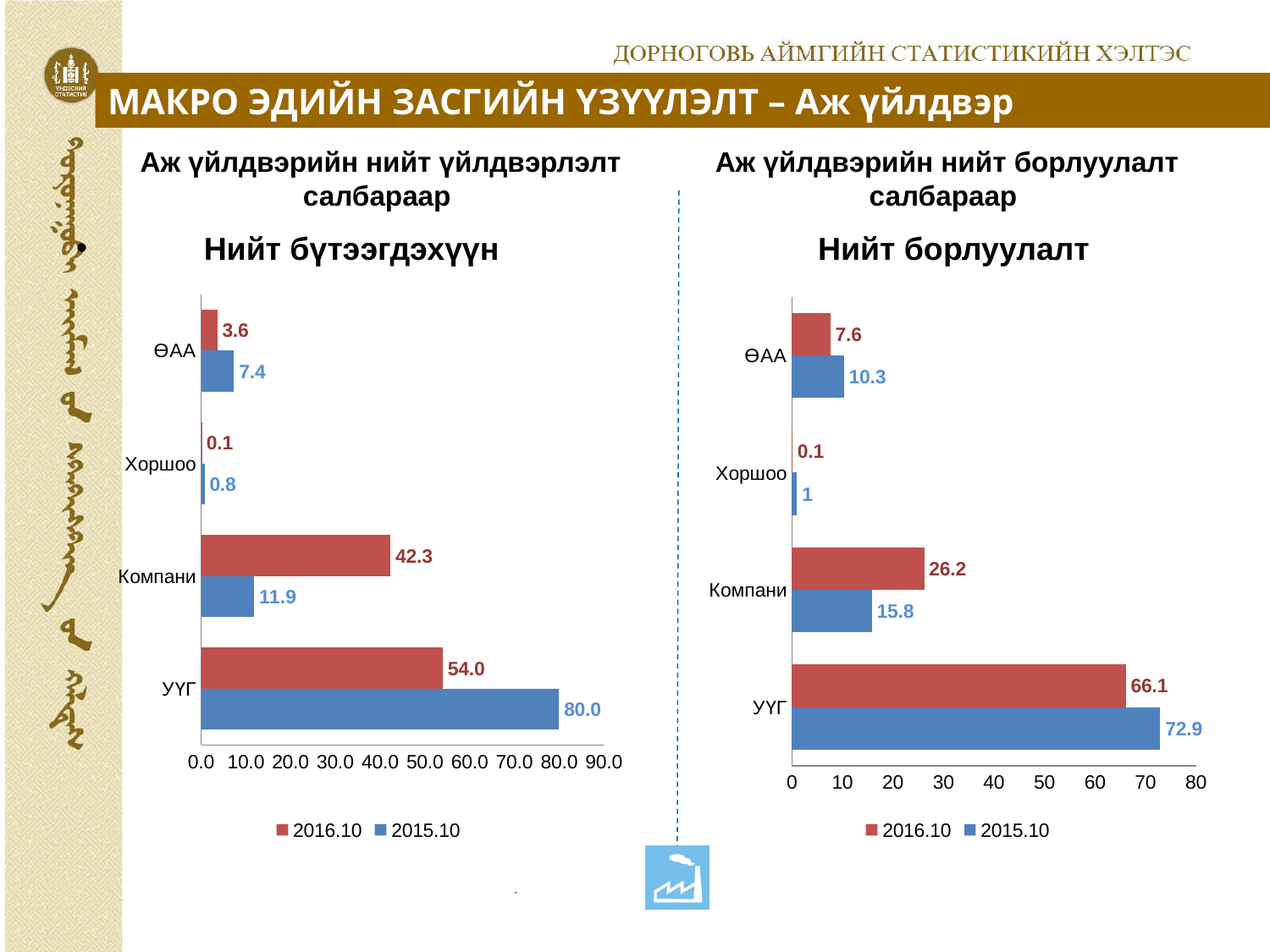
How many series does the legend of the 'Нийт бүтээгдэхүүн' chart list? 2 In the 'Нийт бүтээгдэхүүн' chart, what is the 2015.10 value for УҮГ? 80.0 In the 'Нийт борлуулалт' chart, what is the 2015.10 value for Компани? 15.8 In the 'Нийт бүтээгдэхүүн' chart, what is the 2016.10 value for Компани? 42.3 In the 'Нийт борлуулалт' chart, what is the difference between the 2016.10 and 2015.10 values for Компани? 10.4 How many categories are shown in the 'Нийт борлуулалт' chart? 4 In the 'Нийт бүтээгдэхүүн' chart, what is the difference between the 2015.10 and 2016.10 values for УҮГ? 26.0 In the 'Нийт борлуулалт' chart, which category has the lowest 2015.10 value? Хоршоо In the 'Нийт бүтээгдэхүүн' chart, which is larger for Компани: the 2016.10 value or the 2015.10 value? 2016.10 What type of chart is the 'Нийт борлуулалт' chart? Bar chart In the 'Нийт борлуулалт' chart, what is the 2016.10 value for ӨАА? 7.6 In the 'Нийт бүтээгдэхүүн' chart, which category has the highest 2016.10 value? УҮГ